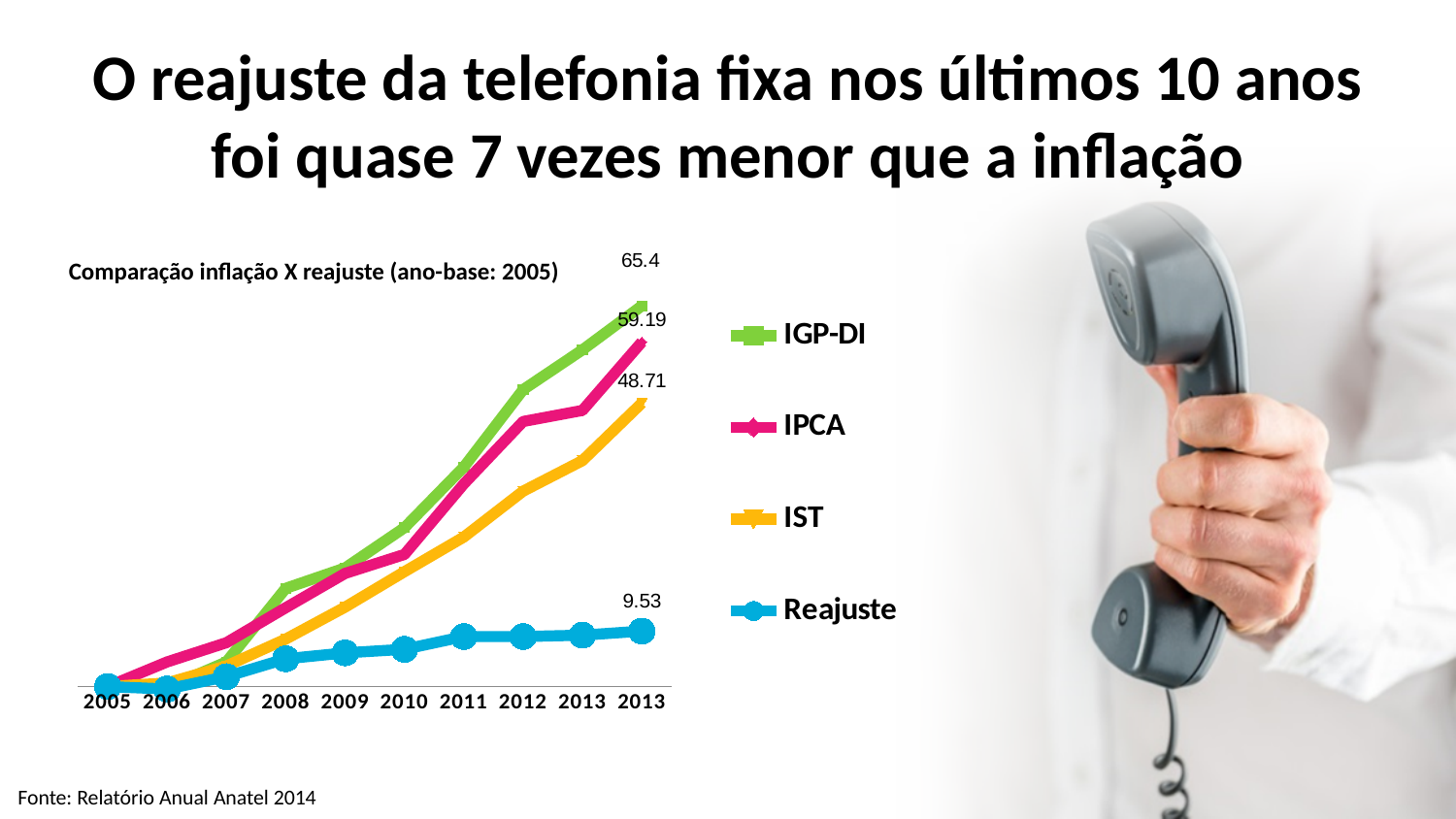
What is the final labelled value of the IPCA series? 59.19 What is the final labelled value of the IGP-DI series? 65.4 What is the title of the chart? Comparação inflação X reajuste (ano-base: 2005) Does the Reajuste series rise or fall from 2005 to the last point? rise What is the final labelled value of the Reajuste series? 9.53 Which series ends with the highest value at the last point on the chart? IGP-DI What is the final labelled value of the IST series? 48.71 What is the difference between the final values of IGP-DI and Reajuste? 55.87 How many series does the chart legend list? 4 Which series ends with the lowest value at the last point on the chart? Reajuste What type of chart is shown on the slide? line chart How many points are plotted along the x axis of the chart? 10